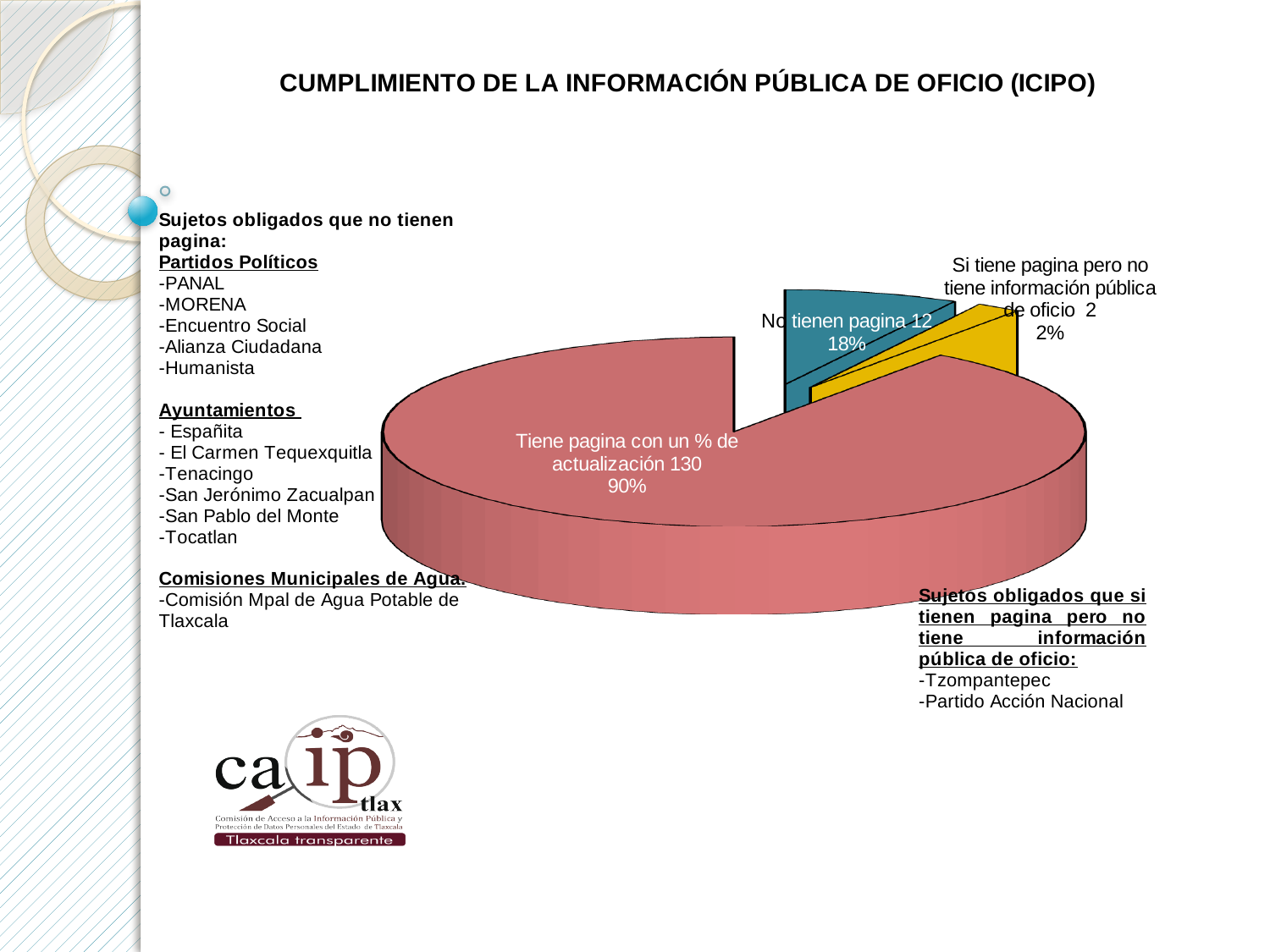
Which slice of the pie chart is the smallest? Si tiene pagina pero no tiene información pública de oficio What is the title of the slide containing the pie chart? CUMPLIMIENTO DE LA INFORMACIÓN PÚBLICA DE OFICIO (ICIPO) What share of the pie does the slice 'Si tiene pagina pero no tiene información pública de oficio' represent? 2% What is the count shown for the slice 'Si tiene pagina pero no tiene información pública de oficio'? 2 What percentage is shown for the slice 'No tienen pagina'? 18% Which slice of the pie chart is the largest? Tiene pagina con un % de actualización What is the count shown for the slice 'Tiene pagina con un % de actualización'? 130 Which has a larger count: 'No tienen pagina' or 'Si tiene pagina pero no tiene información pública de oficio'? No tienen pagina How many slices does the pie chart have? 3 What share of the pie does the slice 'Tiene pagina con un % de actualización' represent? 90% What kind of chart is shown on the slide? Pie chart What is the difference between the count for 'Tiene pagina con un % de actualización' and the count for 'No tienen pagina'? 118